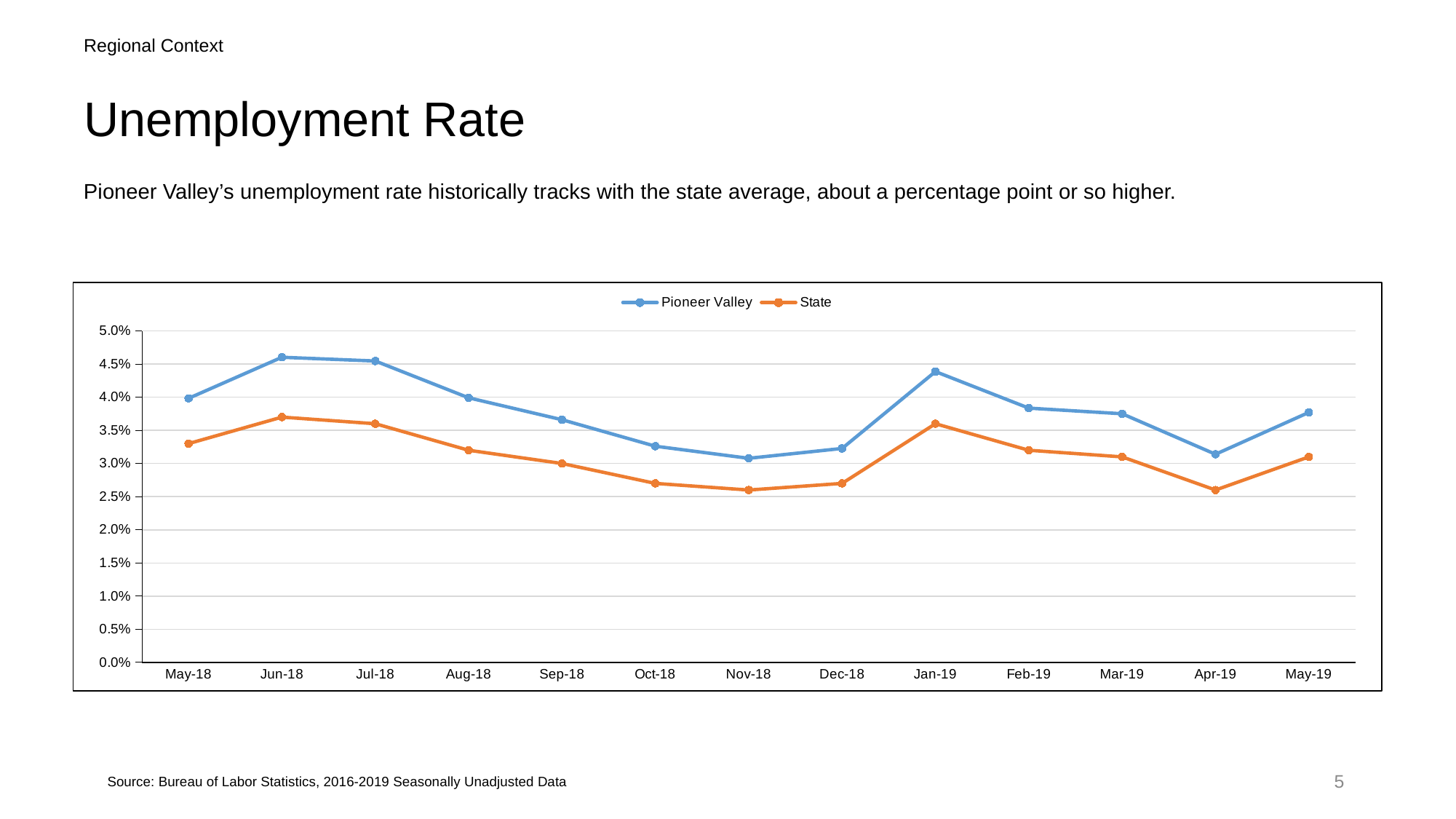
How many months are plotted along the x axis? 13 What colour is the State line in the chart? Orange How many series does the legend list? 2 Do the Pioneer Valley values rise or fall from Jul-18 to Nov-18? fall Do the State values rise or fall from Nov-18 to Jan-19? rise What kind of chart is shown on the slide? Line chart For Pioneer Valley, which month has the larger value, Jan-19 or Apr-19? Jan-19 Is the State value for Jun-18 greater or less than 3.5%? greater Is the Pioneer Valley value for Jan-19 greater or less than 4.0%? greater Is the State value for Nov-18 greater or less than 3.0%? less Which series has the higher value in Jan-19, Pioneer Valley or State? Pioneer Valley